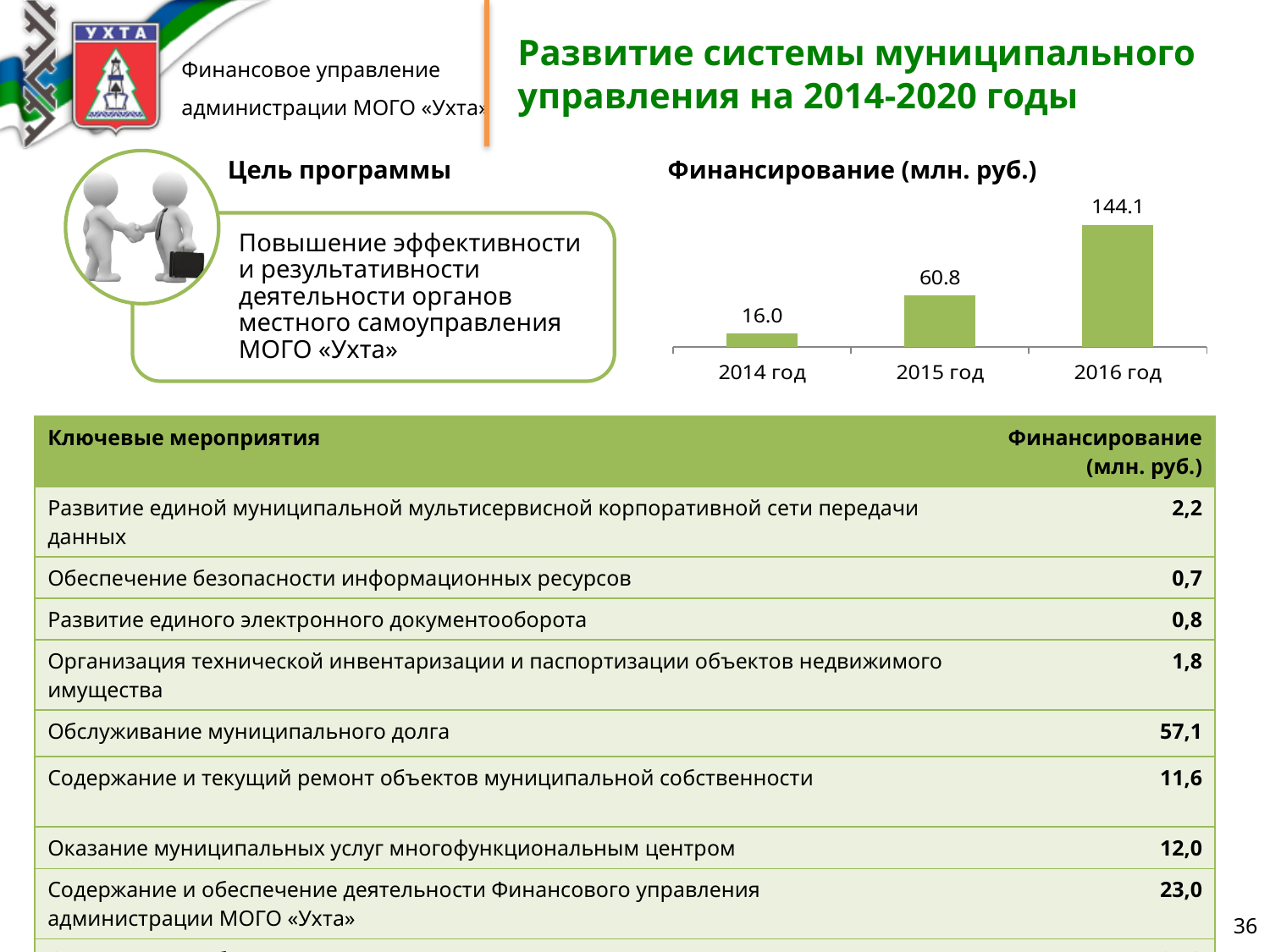
What is the value for 2015 год in the Финансирование (млн. руб.) chart? 60.8 What is the value for 2016 год in the Финансирование (млн. руб.) chart? 144.1 What is the value for 2014 год in the Финансирование (млн. руб.) chart? 16.0 Which year has the highest value in the Финансирование (млн. руб.) chart? 2016 год What is the title of the chart on the slide? Финансирование (млн. руб.) What is the difference between the values for 2016 год and 2015 год in the Финансирование (млн. руб.) chart? 83.3 Which is larger in the Финансирование (млн. руб.) chart, the value for 2014 год or 2015 год? 2015 год What kind of chart is the Финансирование (млн. руб.) chart? bar chart How many years are shown in the Финансирование (млн. руб.) chart? 3 Which year has the lowest value in the Финансирование (млн. руб.) chart? 2014 год Do the values in the Финансирование (млн. руб.) chart rise or fall from 2014 год to 2016 год? rise What is the difference between the values for 2015 год and 2014 год in the Финансирование (млн. руб.) chart? 44.8